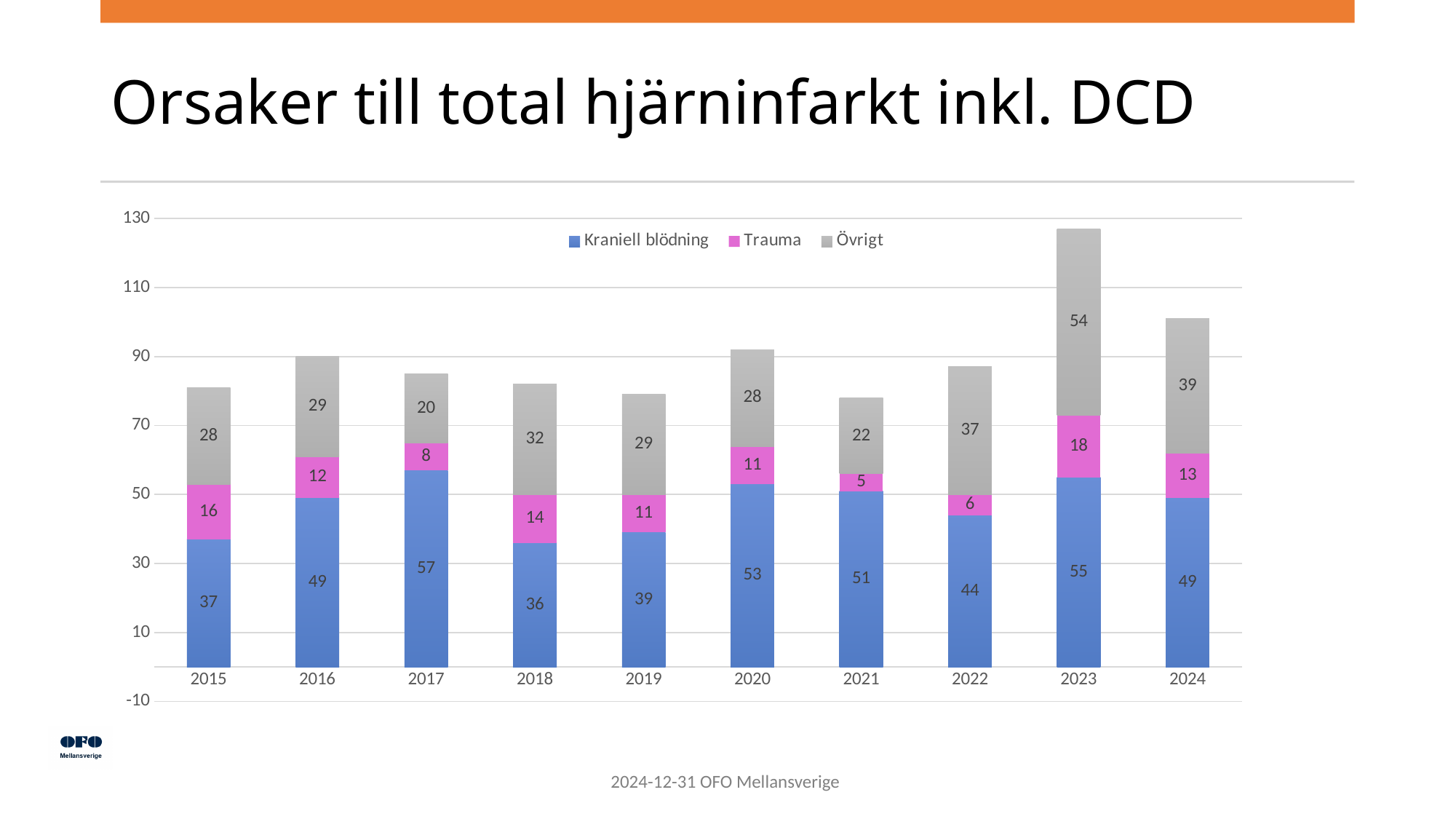
How many years are shown on the x axis? 10 What is the difference between the Kraniell blödning values for 2017 and 2018? 21 What is the value for Kraniell blödning in 2017? 57 Which year has the lowest value for Trauma? 2021 What is the total of the stacked bar for 2023? 127 How many series does the legend list? 3 What is the value for Trauma in 2023? 18 Which year has the highest value for Övrigt? 2023 What is the value for Övrigt in 2022? 37 What kind of chart is shown on the slide? Stacked bar chart Which is larger, the Övrigt value for 2018 or the Övrigt value for 2019? 2018 What is the total of the stacked bar for 2015? 81